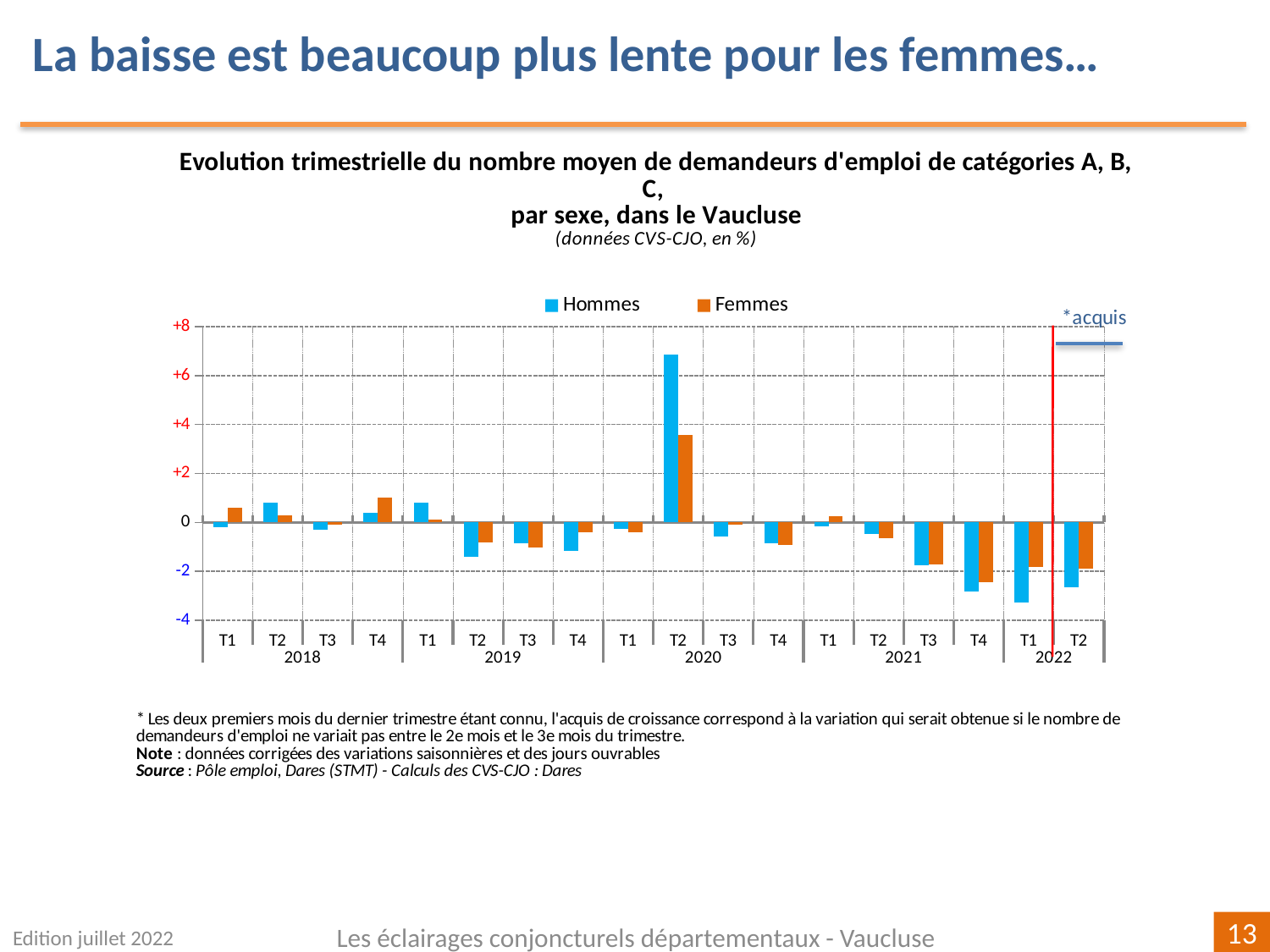
Is the value for Femmes in T2 2020 greater or less than +4? less How many quarters are plotted along the x axis? 18 In which quarter is the value for Femmes the lowest? T4 2021 What colour are the bars for the Femmes series? Orange Is the value for Hommes in T1 2022 greater or less than -2? less In which quarter is the value for Hommes the highest? T2 2020 Is the value for Hommes in T2 2020 greater or less than +6? greater In which quarter is the value for Hommes the lowest? T1 2022 What kind of chart is shown on the slide? Bar chart In T2 2020, which series has the larger value, Hommes or Femmes? Hommes In which quarter is the value for Femmes the highest? T2 2020 How many series does the legend list? 2